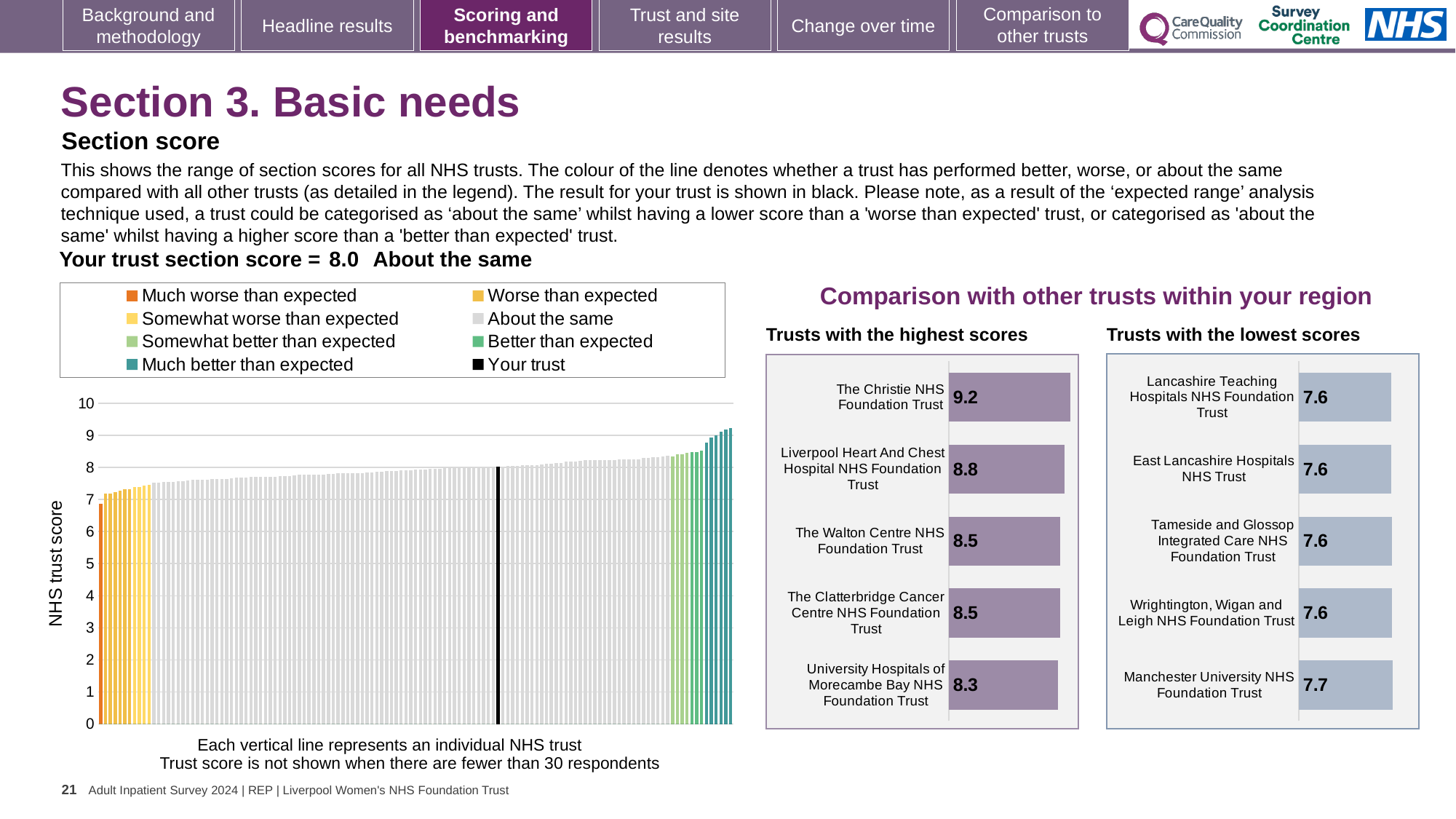
On the 'Trusts with the lowest scores' chart, what is the score for East Lancashire Hospitals NHS Trust? 7.6 On the 'Trusts with the highest scores' chart, what is the score for Liverpool Heart And Chest Hospital NHS Foundation Trust? 8.8 On the 'Trusts with the highest scores' chart, how many trusts are shown? 5 On the 'Trusts with the highest scores' chart, what is the difference between the scores of The Christie NHS Foundation Trust and University Hospitals of Morecambe Bay NHS Foundation Trust? 0.9 On the NHS trust score chart on the left, what is the section score for your trust (the black bar)? 8.0 What kind of chart is the NHS trust score chart on the left of the slide? Bar chart On the 'Trusts with the highest scores' chart, what is the score for The Christie NHS Foundation Trust? 9.2 On the 'Trusts with the lowest scores' chart, which has the larger score: Manchester University NHS Foundation Trust or Wrightington, Wigan and Leigh NHS Foundation Trust? Manchester University NHS Foundation Trust On the 'Trusts with the highest scores' chart, which trust has the lowest score? University Hospitals of Morecambe Bay NHS Foundation Trust On the 'Trusts with the lowest scores' chart, which trust has the highest score? Manchester University NHS Foundation Trust On the 'Trusts with the lowest scores' chart, what is the score for Manchester University NHS Foundation Trust? 7.7 On the NHS trust score chart on the left, how many entries does the legend list? 8